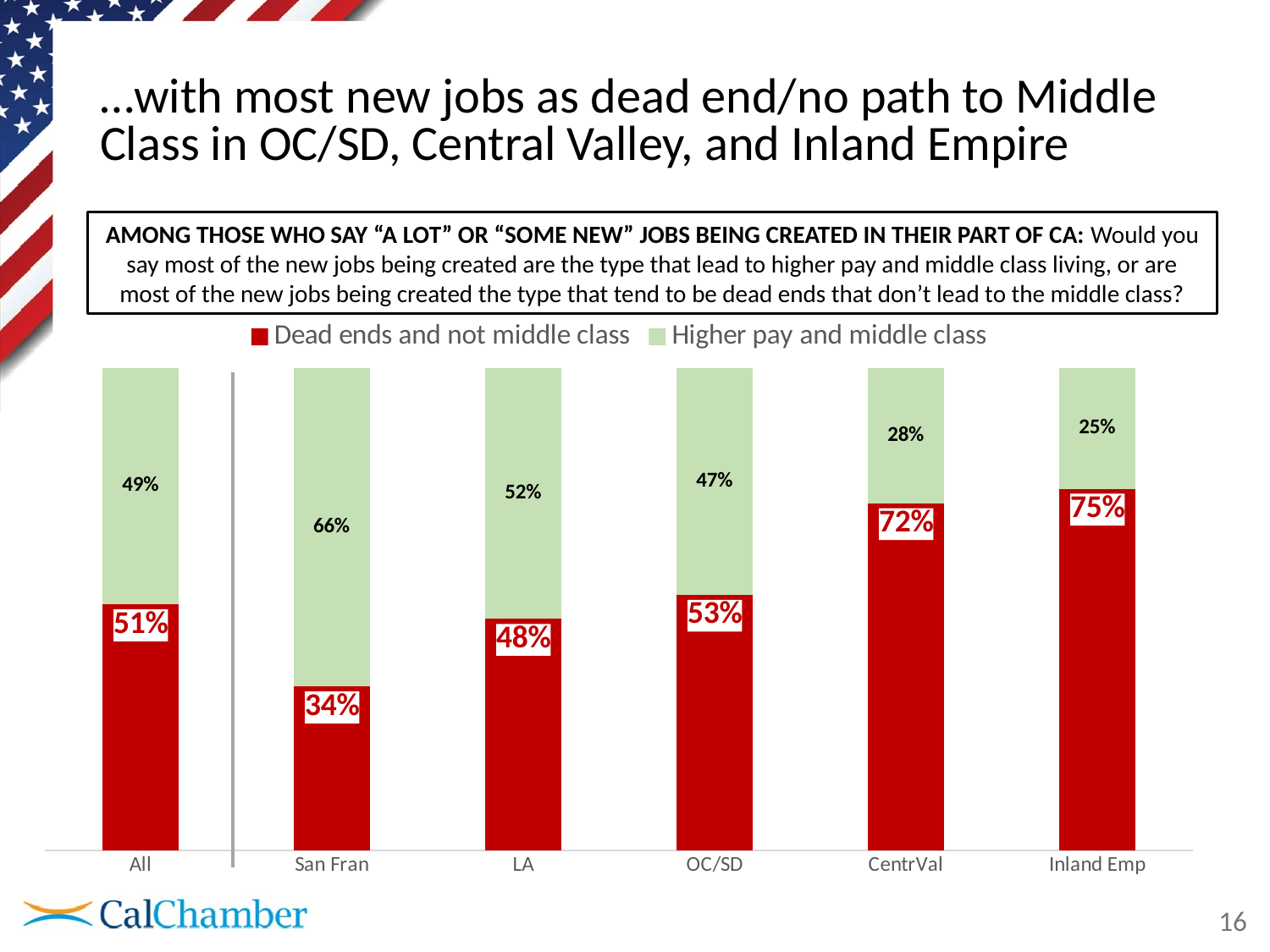
What percentage of respondents in CentrVal say most new jobs lead to higher pay and middle class? 28% What is the 'Dead ends and not middle class' value for OC/SD? 53% How many series does the legend list? 2 What colour represents 'Dead ends and not middle class' in the chart? Red How many regions/categories are shown on the x axis? 6 What percentage of respondents in San Fran say most new jobs are dead ends and not middle class? 34% What kind of chart is shown on the slide? Stacked bar chart Which region has the lowest 'Dead ends and not middle class' percentage? San Fran Which region has the highest 'Higher pay and middle class' percentage? San Fran Which is larger: the 'Dead ends and not middle class' value for LA or for OC/SD? OC/SD Which region has the highest 'Dead ends and not middle class' percentage? Inland Emp What is the difference between the 'Dead ends and not middle class' percentages for Inland Emp and All? 24%